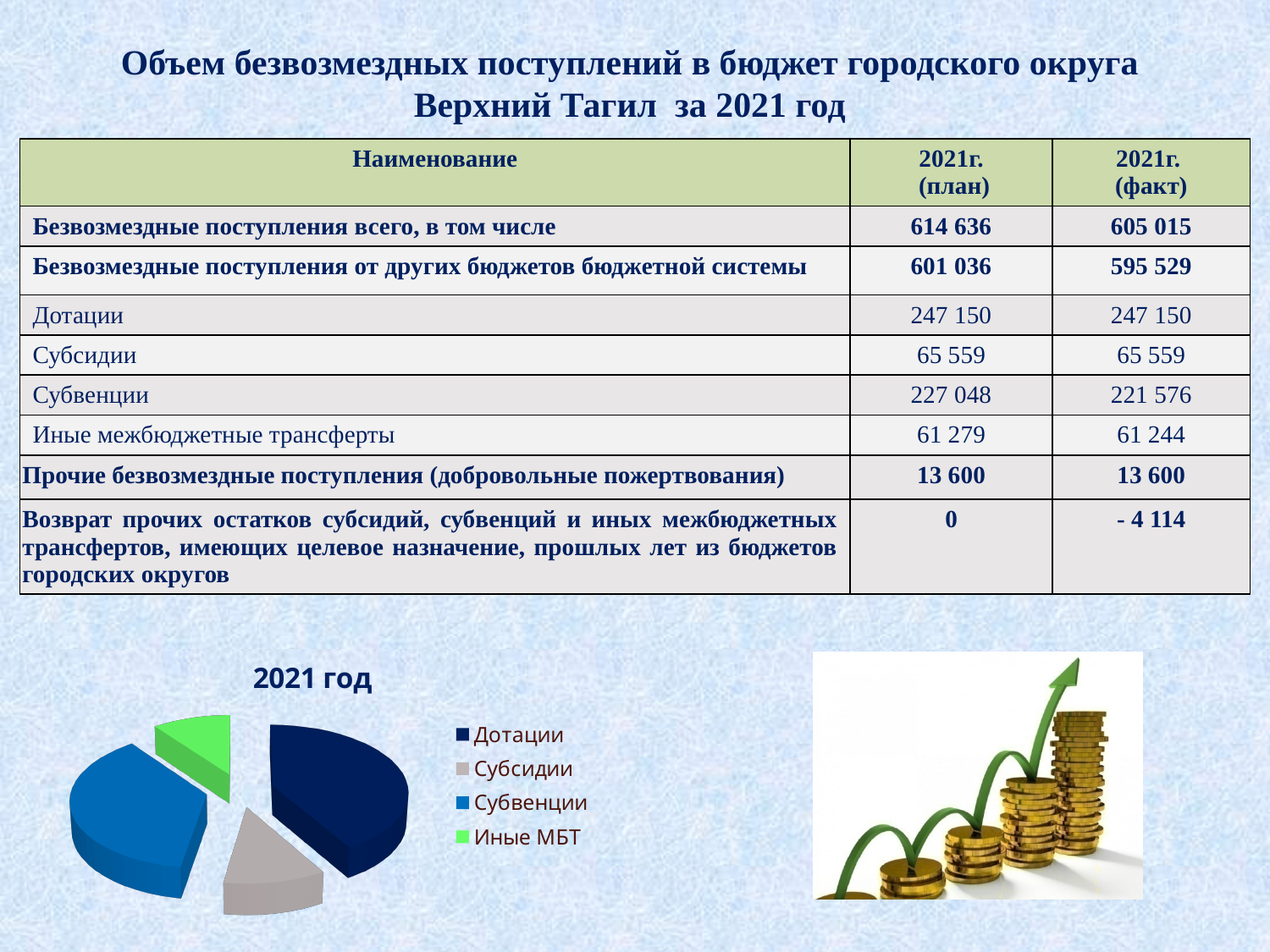
What is the title of the pie chart? 2021 год In the pie chart, which slice is larger: Субвенции or Субсидии? Субвенции How many entries does the legend of the pie chart list? 4 How many slices does the pie chart have? 4 Which legend entry in the pie chart is listed first? Дотации In the pie chart, which slice is larger: Дотации or Субсидии? Дотации In the pie chart, which slice is larger: Субвенции or Иные МБТ? Субвенции Which category in the pie chart has the largest slice? Дотации What kind of chart is shown at the bottom left of the slide? Pie chart Which colour represents Иные МБТ in the pie chart? Green